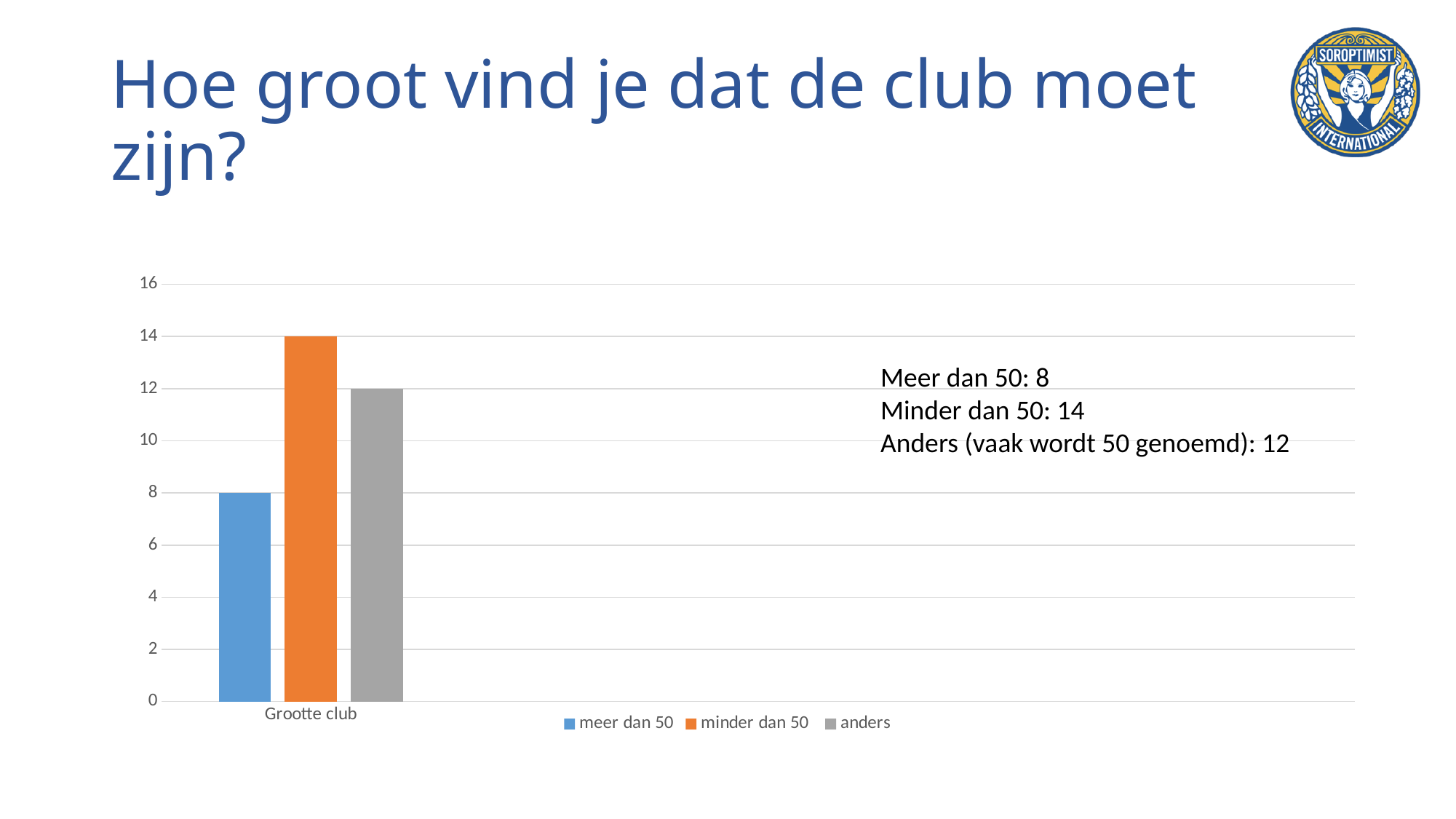
Which series has the lowest value? meer dan 50 Which is larger, the value for "anders" or the value for "meer dan 50"? anders What is the category label shown on the x axis? Grootte club Is the value for "minder dan 50" greater or less than 10? greater What is the value for the series "meer dan 50"? 8 How many series does the legend list? 3 What is the difference between the values for "anders" and "meer dan 50"? 4 What kind of chart is shown on the slide? bar chart What is the value for the series "minder dan 50"? 14 Which series has the highest value? minder dan 50 What is the difference between the values for "minder dan 50" and "meer dan 50"? 6 What is the value for the series "anders"? 12